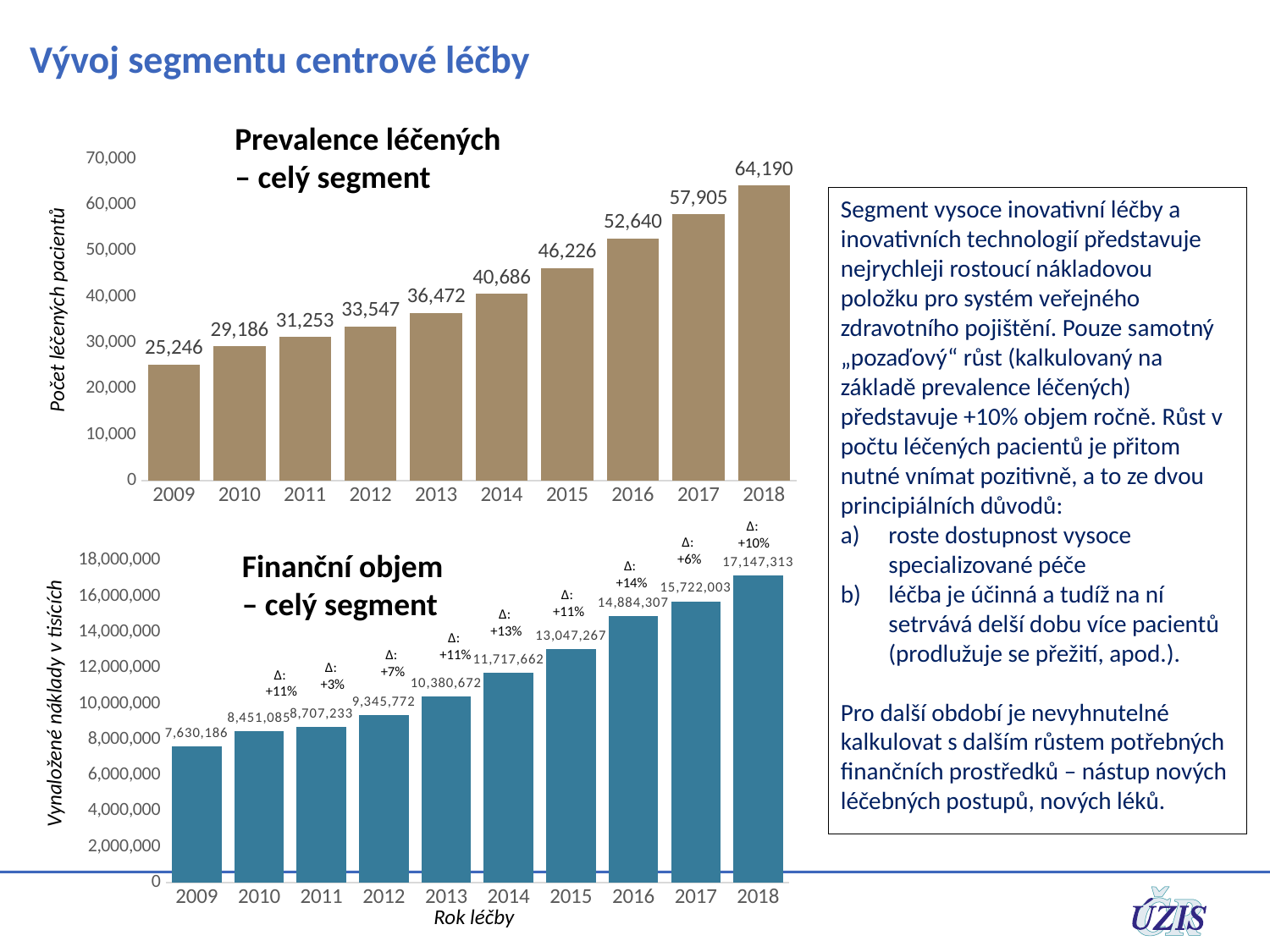
In the 'Prevalence léčených – celý segment' chart, which year has the lowest value? 2009 In the 'Finanční objem – celý segment' chart, which is larger, the value for 2013 or the value for 2012? 2013 In the 'Finanční objem – celý segment' chart, what is the value for 2009? 7,630,186 In the 'Prevalence léčených – celý segment' chart, what is the value for 2014? 40,686 In the 'Finanční objem – celý segment' chart, what is the value for 2016? 14,884,307 What kind of chart is the 'Finanční objem – celý segment' chart? bar chart What is the x-axis label of the 'Finanční objem – celý segment' chart? Rok léčby In the 'Prevalence léčených – celý segment' chart, which year has the highest value? 2018 In the 'Prevalence léčených – celý segment' chart, how many years are shown on the x axis? 10 In the 'Prevalence léčených – celý segment' chart, what is the difference between the values for 2018 and 2017? 6,285 In the 'Prevalence léčených – celý segment' chart, do the values rise or fall from 2009 to 2018? rise In the 'Finanční objem – celý segment' chart, what percentage change (Δ) is shown for 2016? +14%